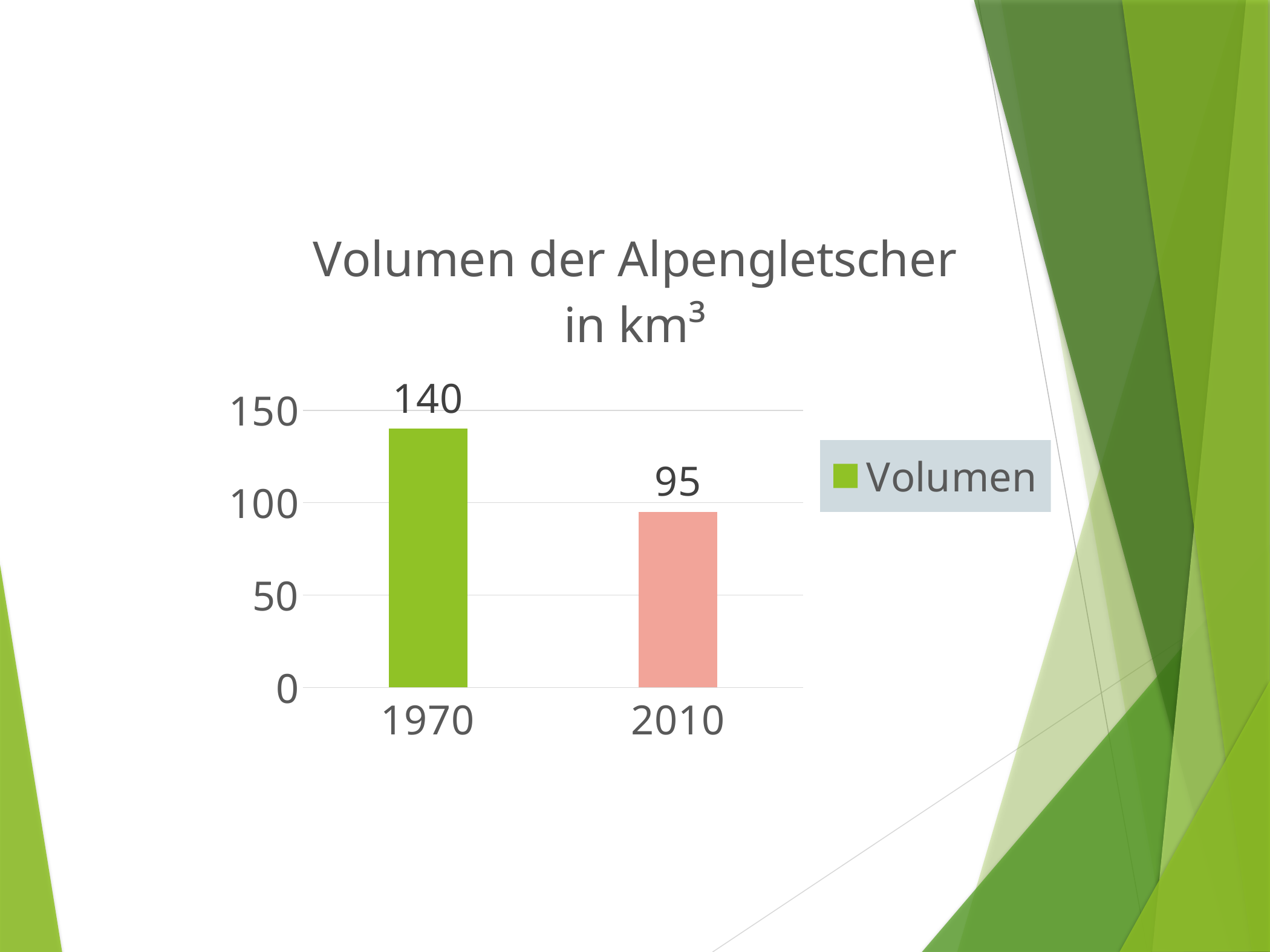
Which is larger, the value for 1970 or the value for 2010? 1970 Which year has the lowest value? 2010 What is the title of the chart? Volumen der Alpengletscher in km³ What is the value for 2010? 95 Do the values rise or fall from 1970 to 2010? fall What kind of chart is shown? bar chart Is the value for 2010 greater or less than 100? less What is the difference between the values for 1970 and 2010? 45 How many series does the legend list? 1 Which year has the highest value? 1970 How many categories are shown on the x axis? 2 What is the value for 1970? 140